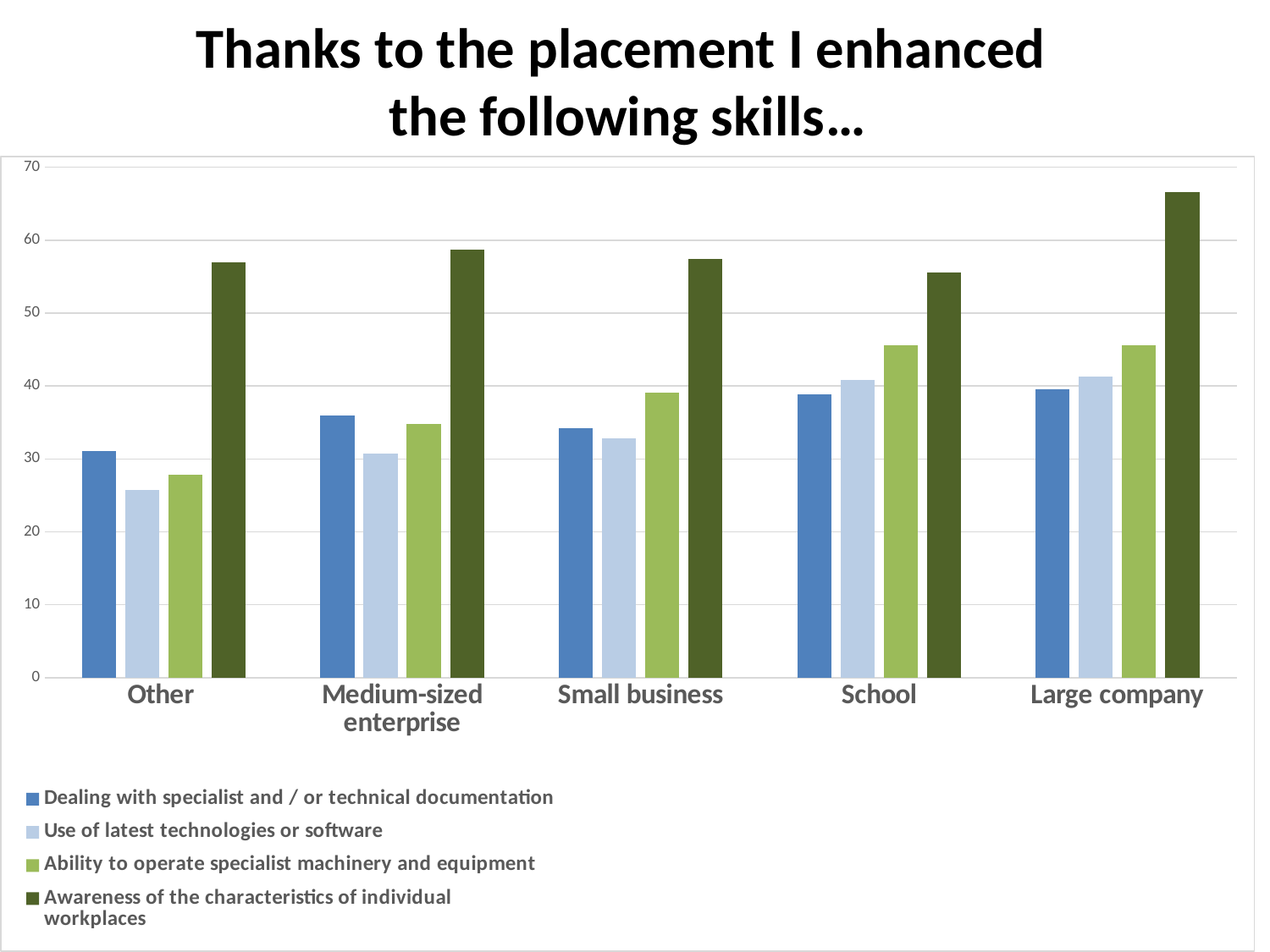
How many series does the legend list? 4 Is the value for 'Awareness of the characteristics of individual workplaces' in the Other category greater or less than 50? greater In the Other category, which is larger: 'Dealing with specialist and / or technical documentation' or 'Use of latest technologies or software'? Dealing with specialist and / or technical documentation How many categories are shown on the x axis? 5 Is the value for 'Dealing with specialist and / or technical documentation' in the Medium-sized enterprise category greater or less than 30? greater Is the value for 'Ability to operate specialist machinery and equipment' in the School category greater or less than 40? greater In the Large company category, which is larger: 'Awareness of the characteristics of individual workplaces' or 'Ability to operate specialist machinery and equipment'? Awareness of the characteristics of individual workplaces What kind of chart is shown on the slide? bar chart In which category is the value for 'Awareness of the characteristics of individual workplaces' highest? Large company In which category is the value for 'Use of latest technologies or software' lowest? Other Which series has the tallest bar in the Small business category? Awareness of the characteristics of individual workplaces